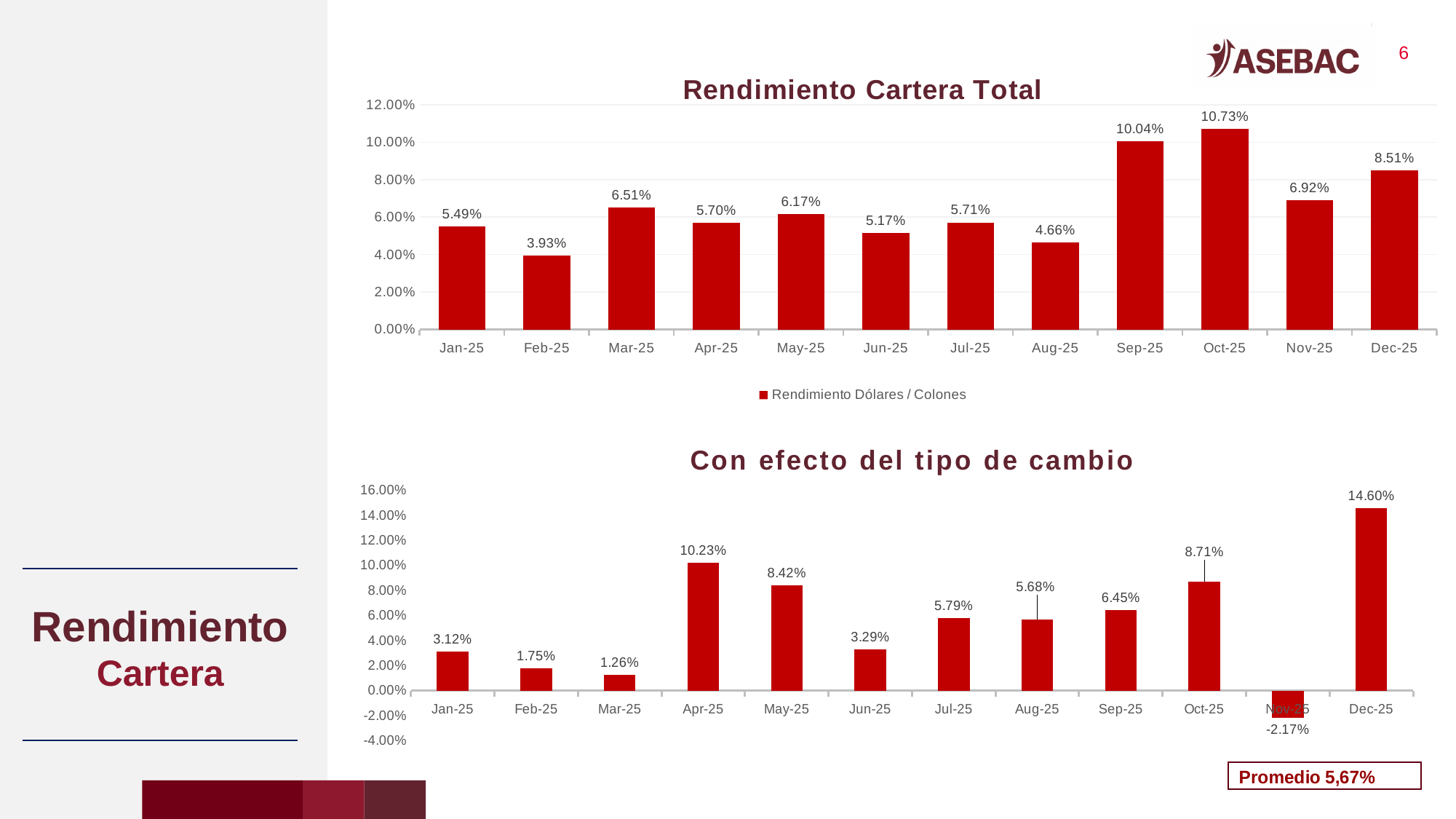
In the 'Con efecto del tipo de cambio' chart, which month has the highest value? Dec-25 In the 'Rendimiento Cartera Total' chart, what is the value for Oct-25? 10.73% In the 'Rendimiento Cartera Total' chart, what series does the legend list? Rendimiento Dólares / Colones In the 'Con efecto del tipo de cambio' chart, which month has the lowest value? Nov-25 In the 'Con efecto del tipo de cambio' chart, what is the value for Nov-25? -2.17% In the 'Rendimiento Cartera Total' chart, how many months are plotted? 12 In the 'Rendimiento Cartera Total' chart, what is the difference between the Sep-25 and Aug-25 values? 5.38% What kind of chart is 'Con efecto del tipo de cambio'? Bar chart In the 'Con efecto del tipo de cambio' chart, what is the difference between the Dec-25 and Oct-25 values? 5.89% In the 'Rendimiento Cartera Total' chart, which month has the lowest value? Feb-25 In the 'Con efecto del tipo de cambio' chart, which is larger, the value for Apr-25 or the value for May-25? Apr-25 In the 'Rendimiento Cartera Total' chart, which month has the highest value? Oct-25